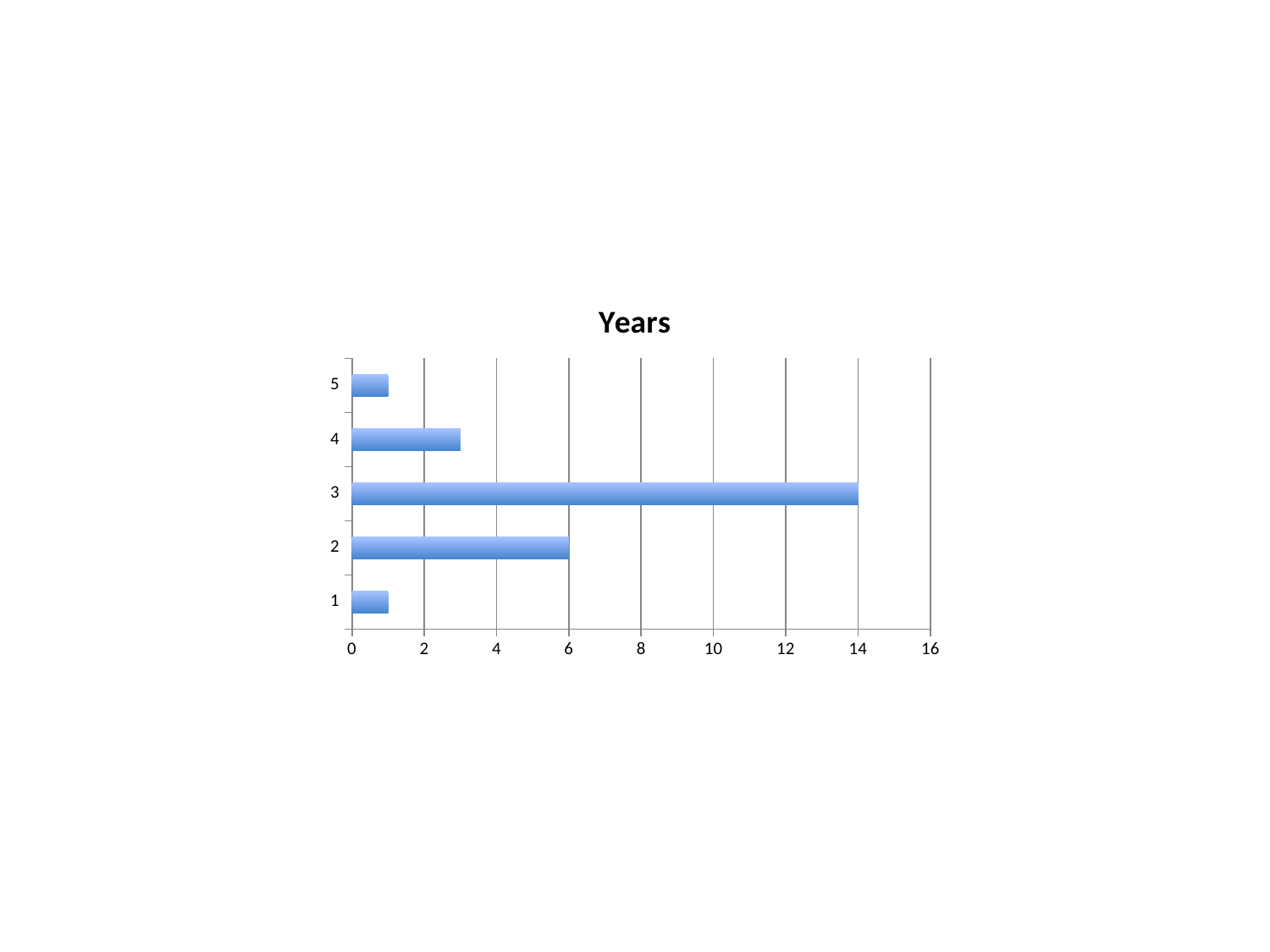
Is the value for category 1 greater or less than 2? less What is the value for category 3? 14 What kind of chart is shown on the slide? bar chart Is the value for category 4 greater or less than 4? less How many categories are shown in the chart? 5 Is the value for category 3 greater or less than 12? greater What is the title of the chart? Years Which category has the highest value? 3 What is the difference between the values for category 3 and category 2? 8 What is the value for category 2? 6 Which has the larger value, category 3 or category 5? 3 Which has the larger value, category 2 or category 4? 2